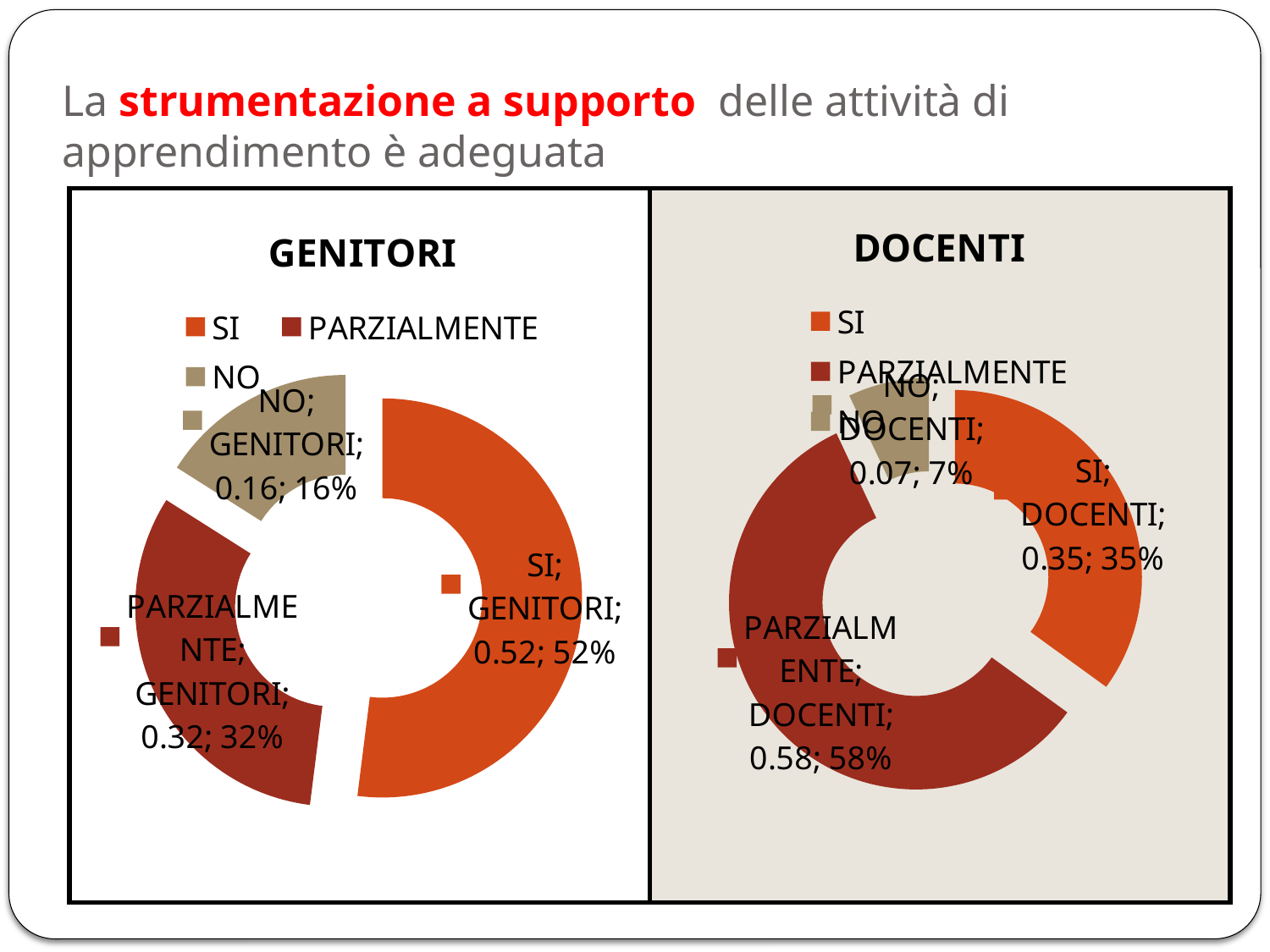
In the DOCENTI chart, which category has the smallest share? NO In the GENITORI chart, which category has the largest share? SI In the DOCENTI chart, what percentage is shown for NO? 7% In the DOCENTI chart, what percentage is shown for PARZIALMENTE? 58% In the DOCENTI chart, what is the difference in percentage points between PARZIALMENTE and SI? 23 In the GENITORI chart, what percentage is shown for NO? 16% Which is larger: the SI share in the GENITORI chart or the SI share in the DOCENTI chart? GENITORI How many categories does the GENITORI chart show? 3 In the GENITORI chart, what percentage is shown for PARZIALMENTE? 32% In the DOCENTI chart, what percentage is shown for SI? 35% What kind of chart is the DOCENTI chart? Doughnut (pie) chart In the GENITORI chart, what percentage is shown for SI? 52%